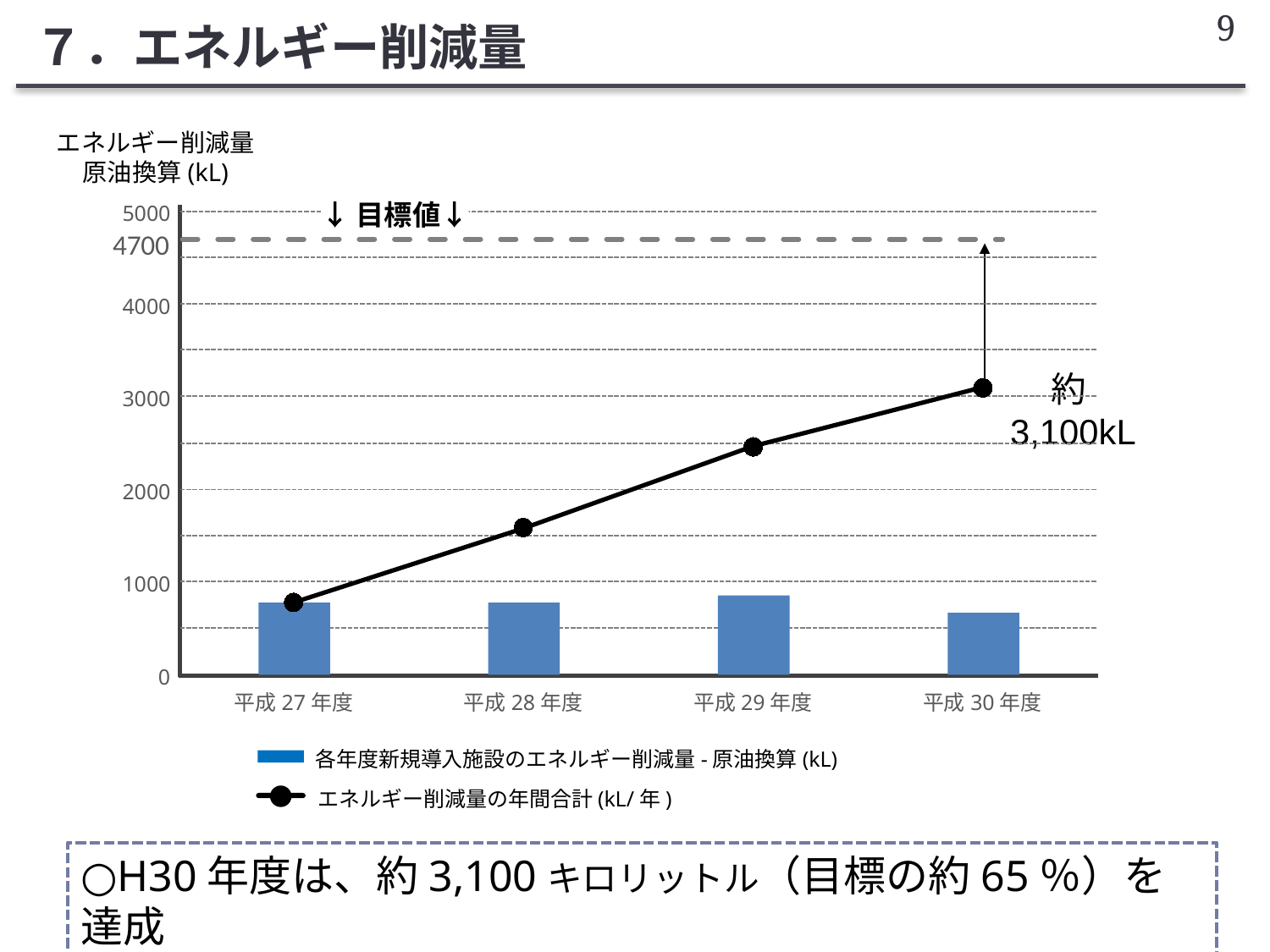
Which fiscal year has the highest bar for 各年度新規導入施設のエネルギー削減量? 平成29年度 Which fiscal year has the lowest bar for 各年度新規導入施設のエネルギー削減量? 平成30年度 Is the line value (年間合計) for 平成28年度 greater or less than 1000? greater What target value (目標値) is marked by the dashed horizontal line? 4700 What kind of chart is shown on the slide? A combined bar and line chart How many fiscal years (categories) are shown on the x axis? 4 Is the line value (年間合計) for 平成29年度 greater or less than 3000? less How many series does the legend list? 2 Is the line value (年間合計) for 平成30年度 greater or less than 3000? greater Which is larger, the bar for 平成29年度 or the bar for 平成30年度? 平成29年度 Does the line series エネルギー削減量の年間合計 rise or fall from 平成27年度 to 平成30年度? Rises